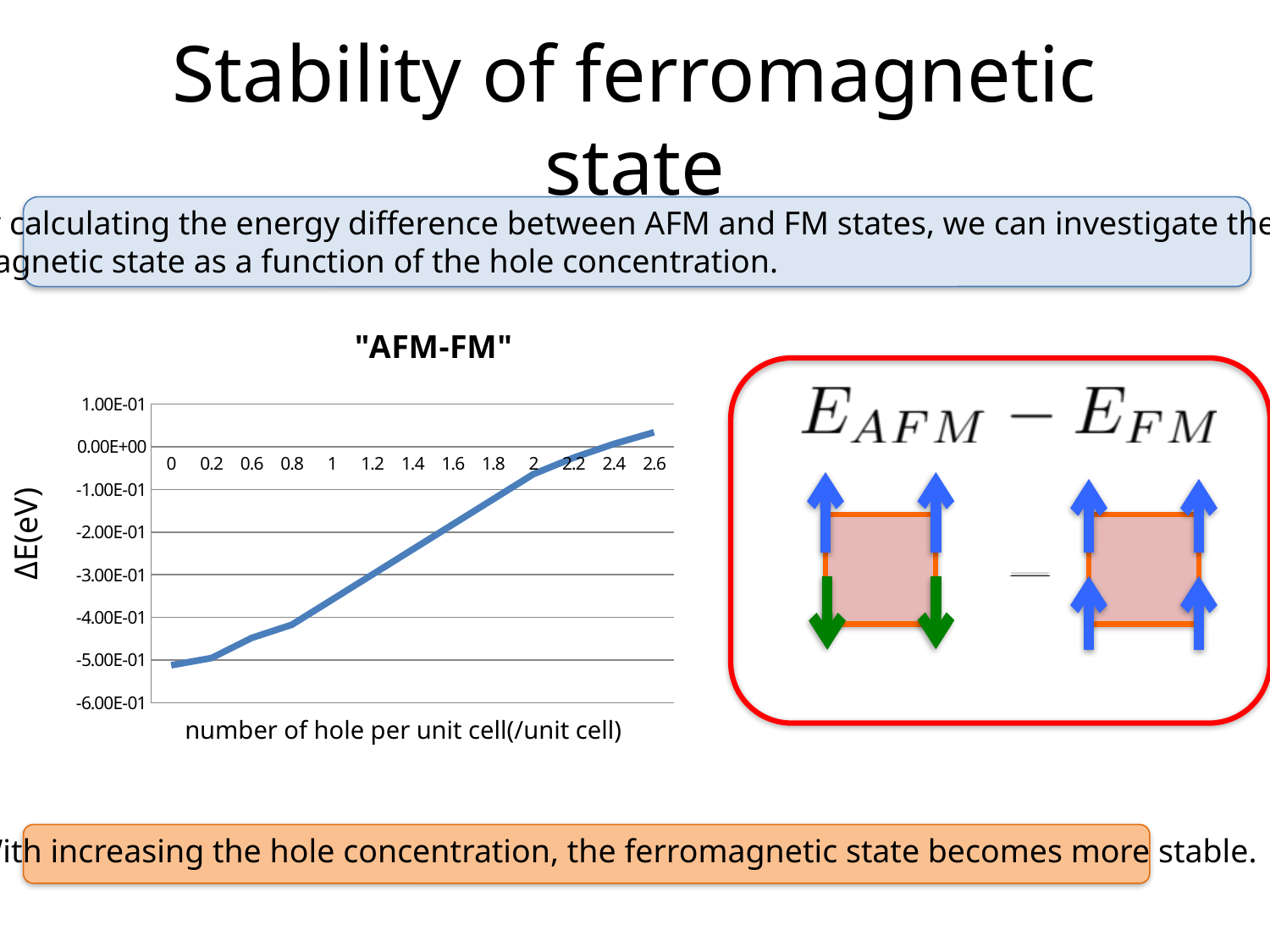
At which x-axis value is the plotted line lowest? 0 Do the values of the line rise or fall as the number of holes per unit cell increases? rise Is the value at 0.2 holes per unit cell greater or less than -4.00E-01? less Which is larger, the value at 0 holes per unit cell or the value at 2.6 holes per unit cell? 2.6 Is the value at 2.6 holes per unit cell greater or less than 0.00E+00? greater What is the title of the chart? "AFM-FM" Is the value at 1.4 holes per unit cell greater or less than -1.00E-01? less What kind of chart is shown on the slide? line chart How many tick labels are shown on the x axis of the chart? 13 At which x-axis value is the plotted line highest? 2.6 What is the label of the x axis of the chart? number of hole per unit cell(/unit cell)